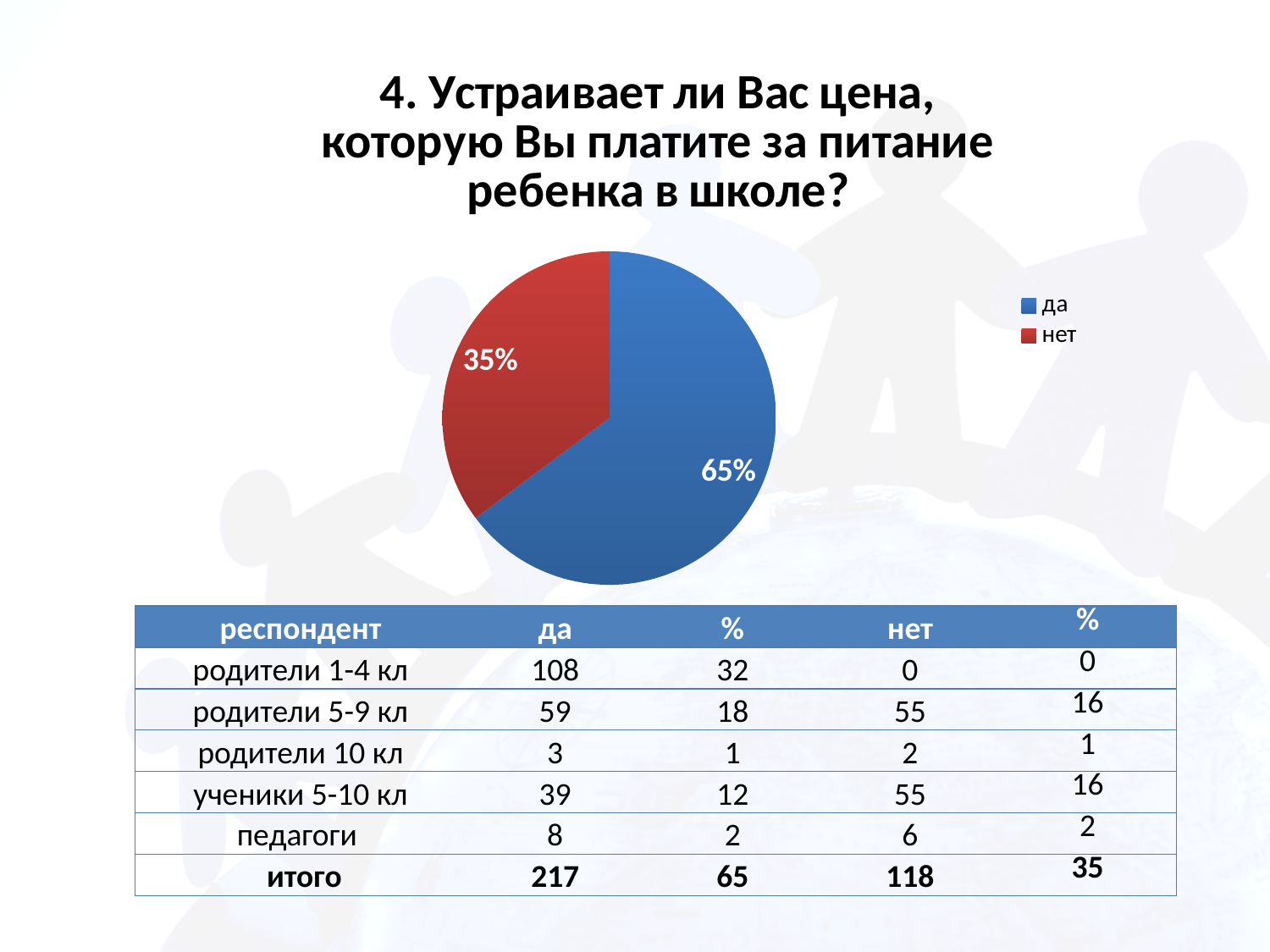
Which slice of the pie chart is the largest? да How many entries does the legend of the pie chart list? 2 What share of the pie does the "нет" slice represent? 35% What colour is the "нет" slice in the pie chart? red What is the difference in percentage points between the "да" and "нет" slices? 30 Which is larger in the pie chart, "да" or "нет"? да Which slice of the pie chart is the smallest? нет What kind of chart is shown on the slide? pie chart What colour is the "да" slice in the pie chart? blue How many slices does the pie chart have? 2 What share of the pie does the "да" slice represent? 65%